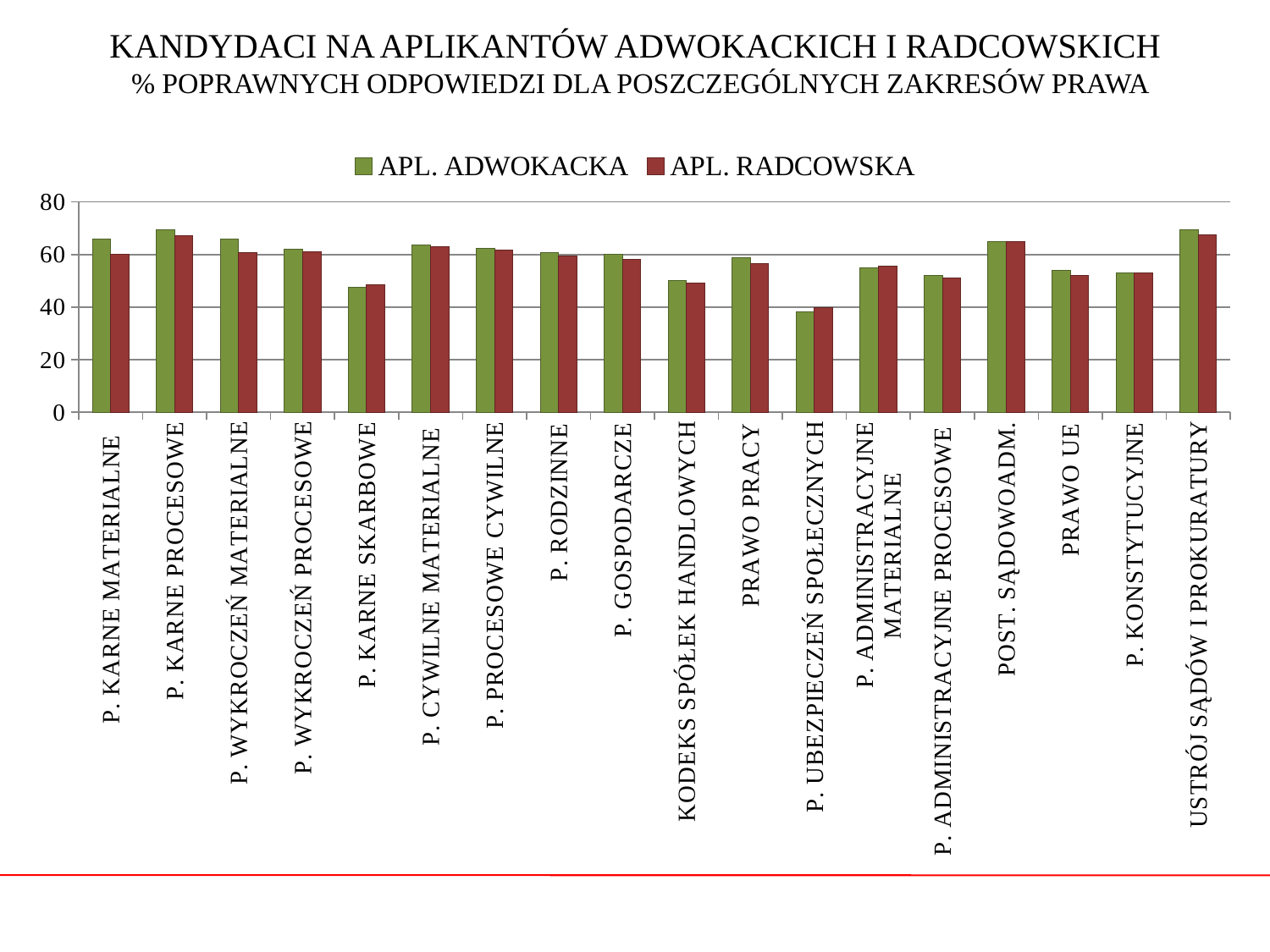
For P. KARNE MATERIALNE, which series has the larger value, APL. ADWOKACKA or APL. RADCOWSKA? APL. ADWOKACKA Which colour represents APL. RADCOWSKA in the legend? red How many categories (areas of law) are shown on the x axis? 18 Which category has the lowest value for APL. RADCOWSKA? P. UBEZPIECZEŃ SPOŁECZNYCH For APL. ADWOKACKA, which is larger: P. KARNE PROCESOWE or P. KARNE SKARBOWE? P. KARNE PROCESOWE Is the APL. ADWOKACKA value for KODEKS SPÓŁEK HANDLOWYCH greater or less than 40? greater How many series does the legend list? 2 Is the APL. ADWOKACKA value for P. KARNE SKARBOWE greater or less than 60? less Is the APL. RADCOWSKA value for PRAWO UE greater or less than 60? less What kind of chart is shown on the slide? bar chart Which category has the lowest value for APL. ADWOKACKA? P. UBEZPIECZEŃ SPOŁECZNYCH